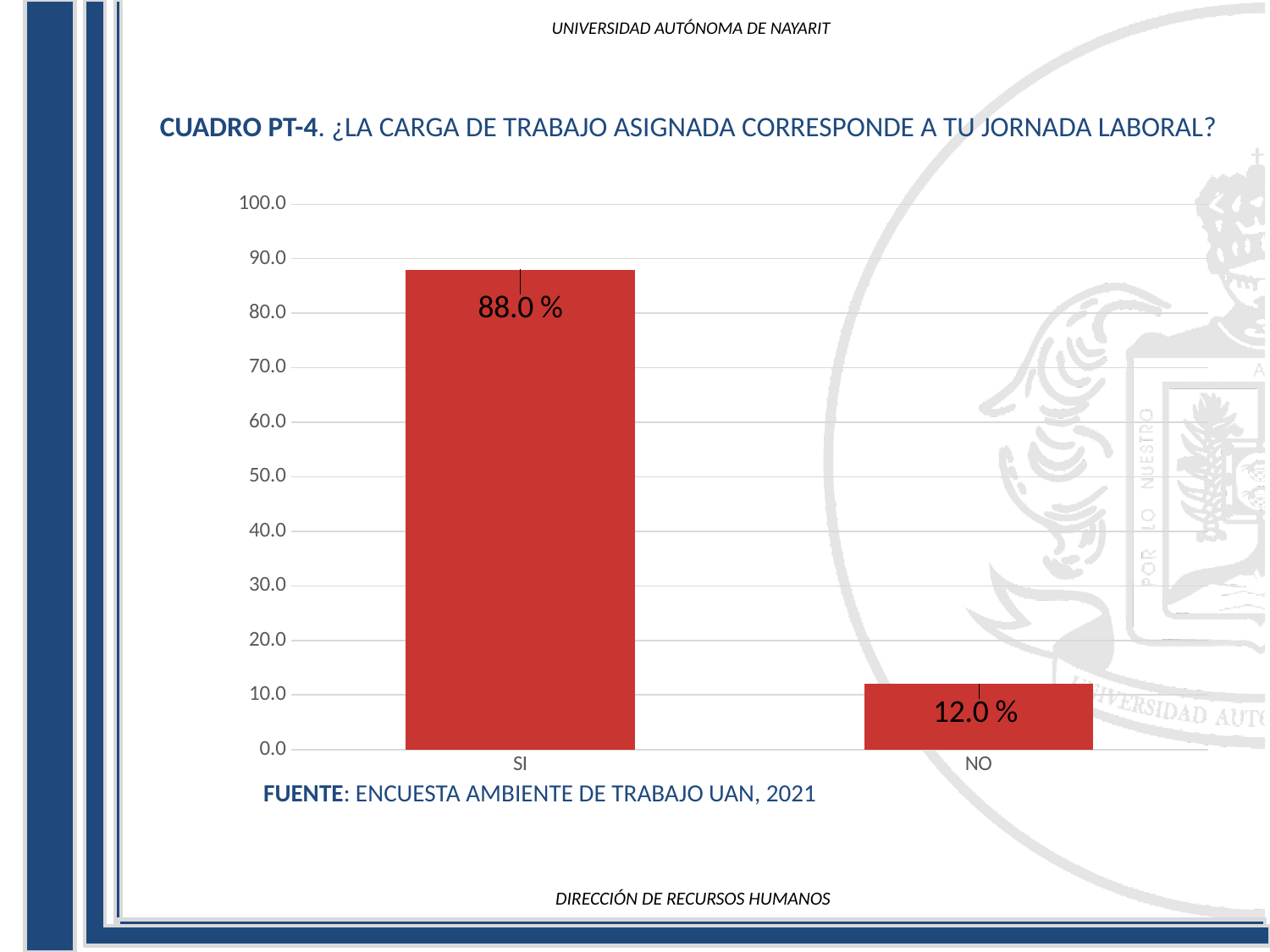
What kind of chart is shown on the slide? bar chart How many categories are shown on the x axis? 2 Is the value for NO greater or less than 20.0? less What is the difference between the values for SI and NO? 76.0 % What is the value for SI? 88.0 % Which category has the highest value? SI What is the value for NO? 12.0 % What is the total of the values for SI and NO? 100.0 % What source is cited below the chart? ENCUESTA AMBIENTE DE TRABAJO UAN, 2021 Is the value for SI greater or less than 80.0? greater Which category has the lowest value? NO Which is larger, the value for SI or the value for NO? SI